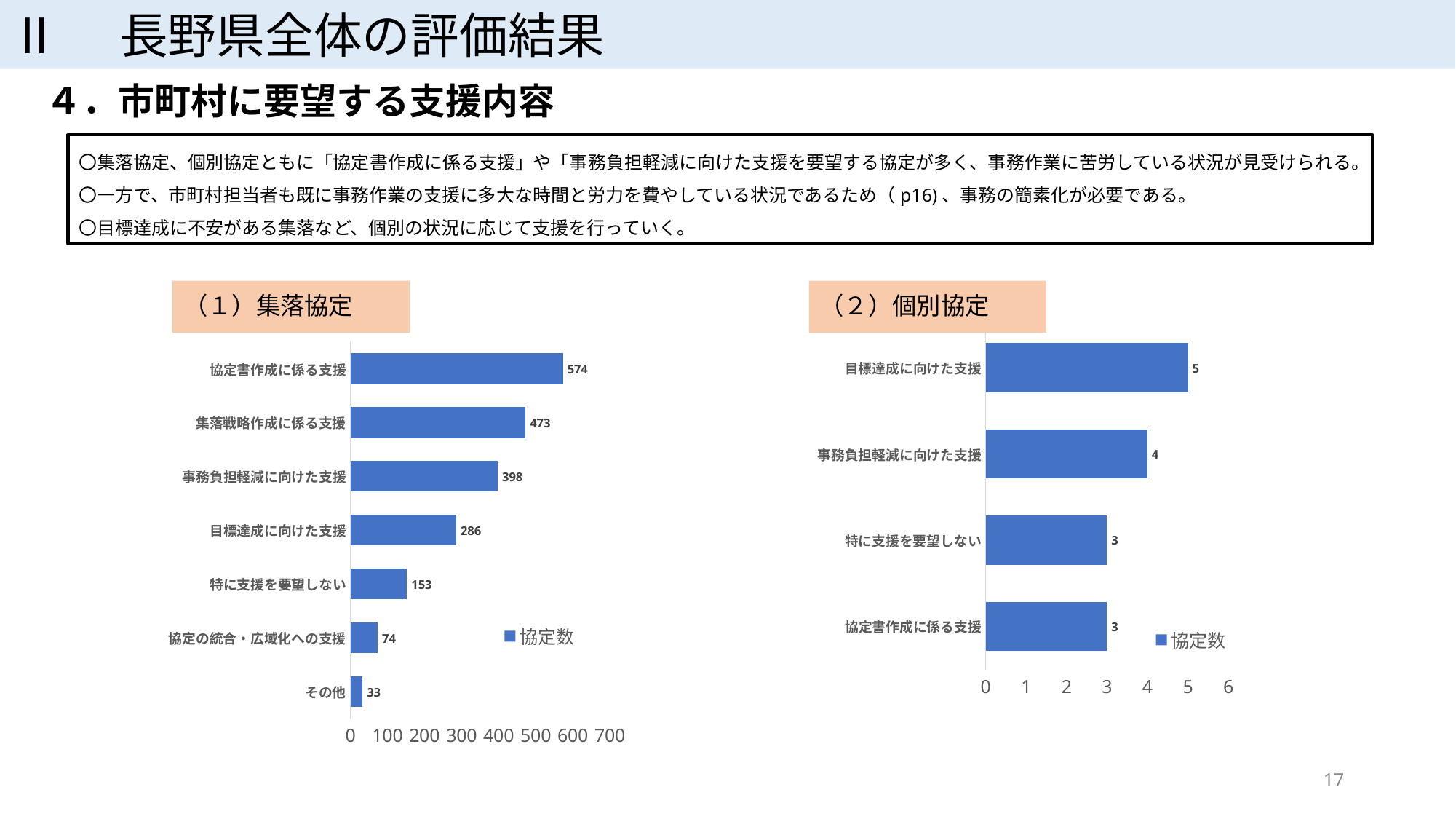
In the (1) 集落協定 chart, what is the value for 協定書作成に係る支援? 574 In the (2) 個別協定 chart, what is the value for 目標達成に向けた支援? 5 What type of chart is the (1) 集落協定 chart? Bar chart In the (1) 集落協定 chart, which is larger: 事務負担軽減に向けた支援 or 特に支援を要望しない? 事務負担軽減に向けた支援 In the (1) 集落協定 chart, which category has the lowest value? その他 How many series does the legend of the (2) 個別協定 chart list? 1 In the (2) 個別協定 chart, which category has the highest value? 目標達成に向けた支援 In the (1) 集落協定 chart, what is the value for 目標達成に向けた支援? 286 In the (1) 集落協定 chart, how many categories are shown? 7 In the (2) 個別協定 chart, what is the difference between 目標達成に向けた支援 and 事務負担軽減に向けた支援? 1 In the (2) 個別協定 chart, how many categories are shown? 4 In the (1) 集落協定 chart, what is the difference between 協定書作成に係る支援 and 集落戦略作成に係る支援? 101